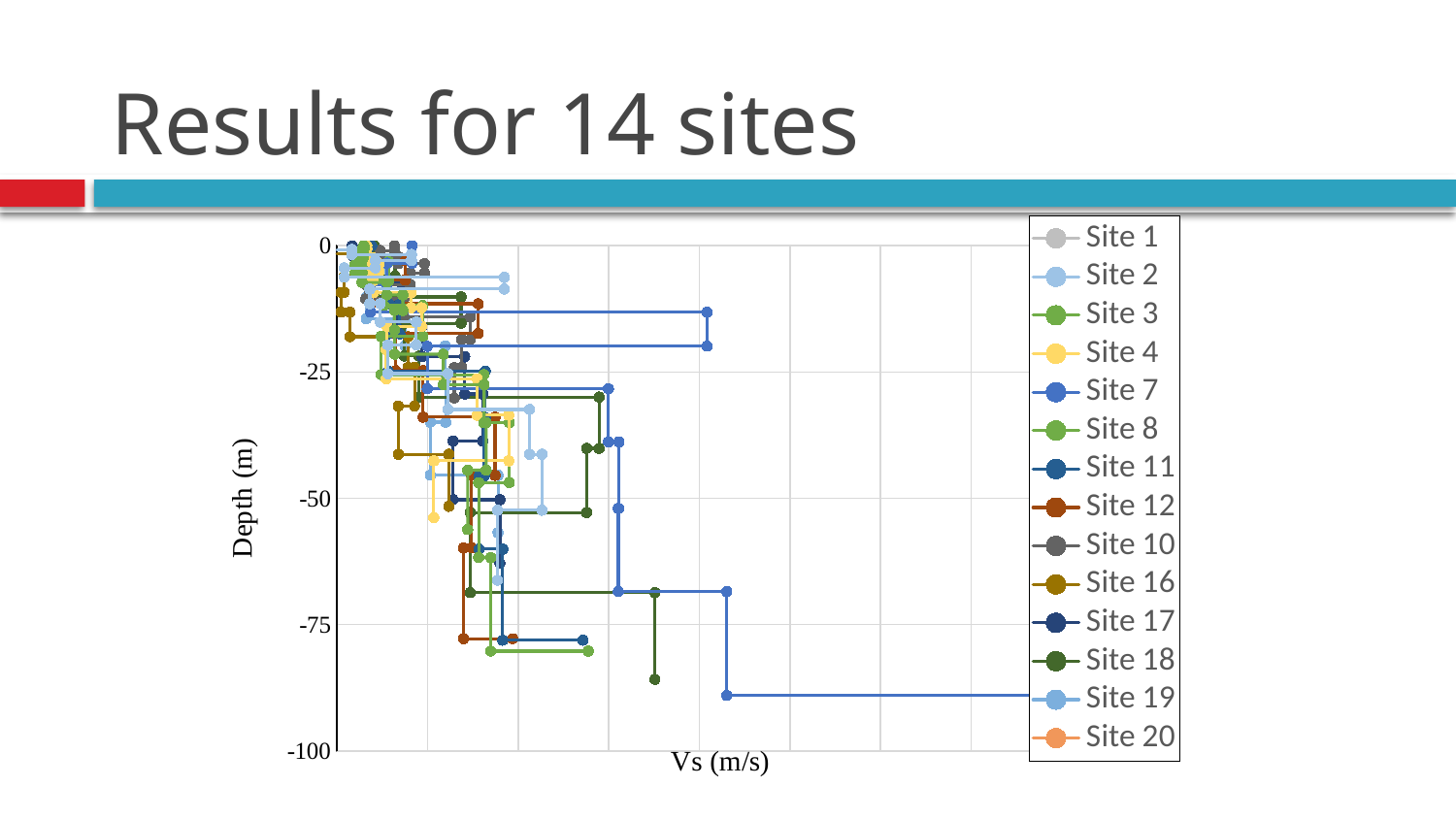
What is the label of the x axis? Vs (m/s) Does any site profile extend deeper than -100 m? No How many series does the legend list? 14 How many tick labels are shown on the y axis? 5 What is the lowest depth value labelled on the y axis? -100 What kind of chart is shown on the slide? line chart What is the label of the y axis? Depth (m) Does the Site 7 profile extend to a depth deeper than -75 m? Yes